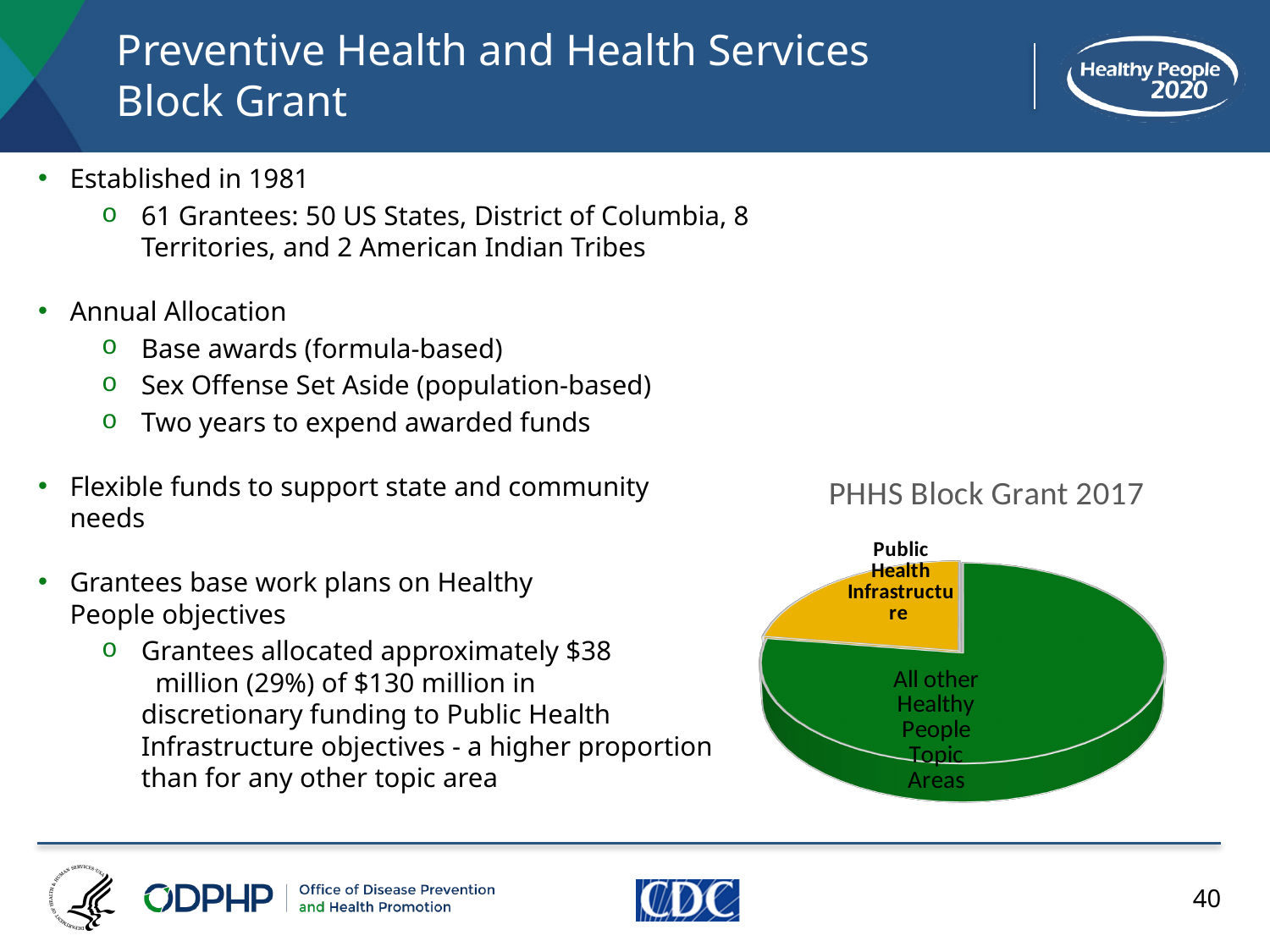
Which slice of the PHHS Block Grant 2017 pie chart is the smallest? Public Health Infrastructure Does the Public Health Infrastructure slice in the PHHS Block Grant 2017 pie chart take up more or less than half of the pie? Less In the PHHS Block Grant 2017 pie chart, which is larger: the Public Health Infrastructure slice or the All other Healthy People Topic Areas slice? All other Healthy People Topic Areas What kind of chart is shown under the title "PHHS Block Grant 2017"? Pie chart What is the title of the chart on the slide? PHHS Block Grant 2017 What colour is the Public Health Infrastructure slice in the PHHS Block Grant 2017 pie chart? Yellow How many slices does the PHHS Block Grant 2017 pie chart have? 2 Which slice of the PHHS Block Grant 2017 pie chart is the largest? All other Healthy People Topic Areas